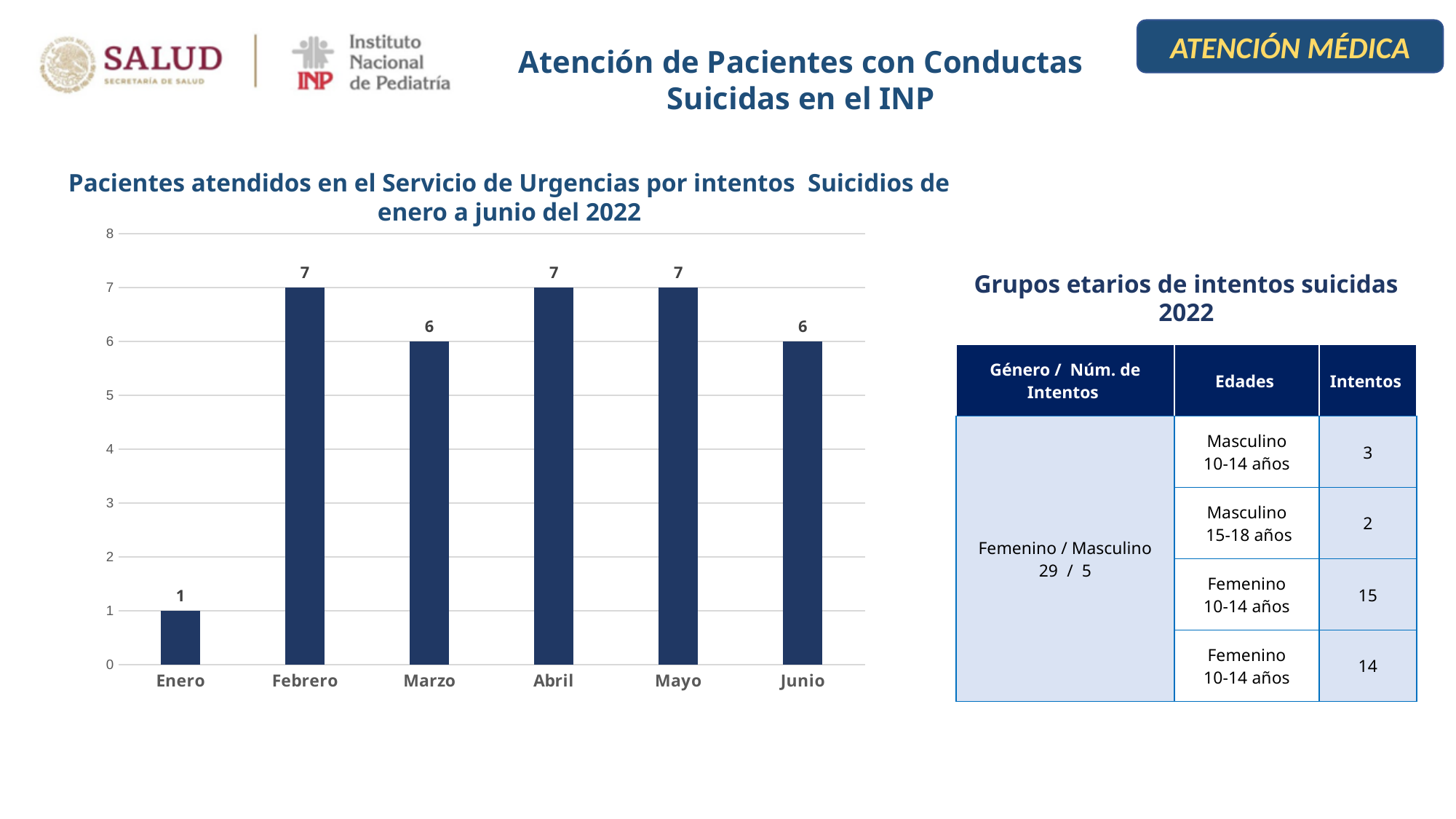
What is the difference between the values for Abril and Junio? 1 What is the value for Enero? 1 What kind of chart is shown? bar chart Which month has the lowest value? Enero What is the title of the chart? Pacientes atendidos en el Servicio de Urgencias por intentos Suicidios de enero a junio del 2022 What is the difference between the values for Febrero and Enero? 6 Do the values rise or fall from Enero to Febrero? rise What is the value for Mayo? 7 How many months are shown on the x axis? 6 Is the value for Junio greater or less than 4? greater What is the value for Marzo? 6 Which is larger, the value for Marzo or the value for Abril? Abril